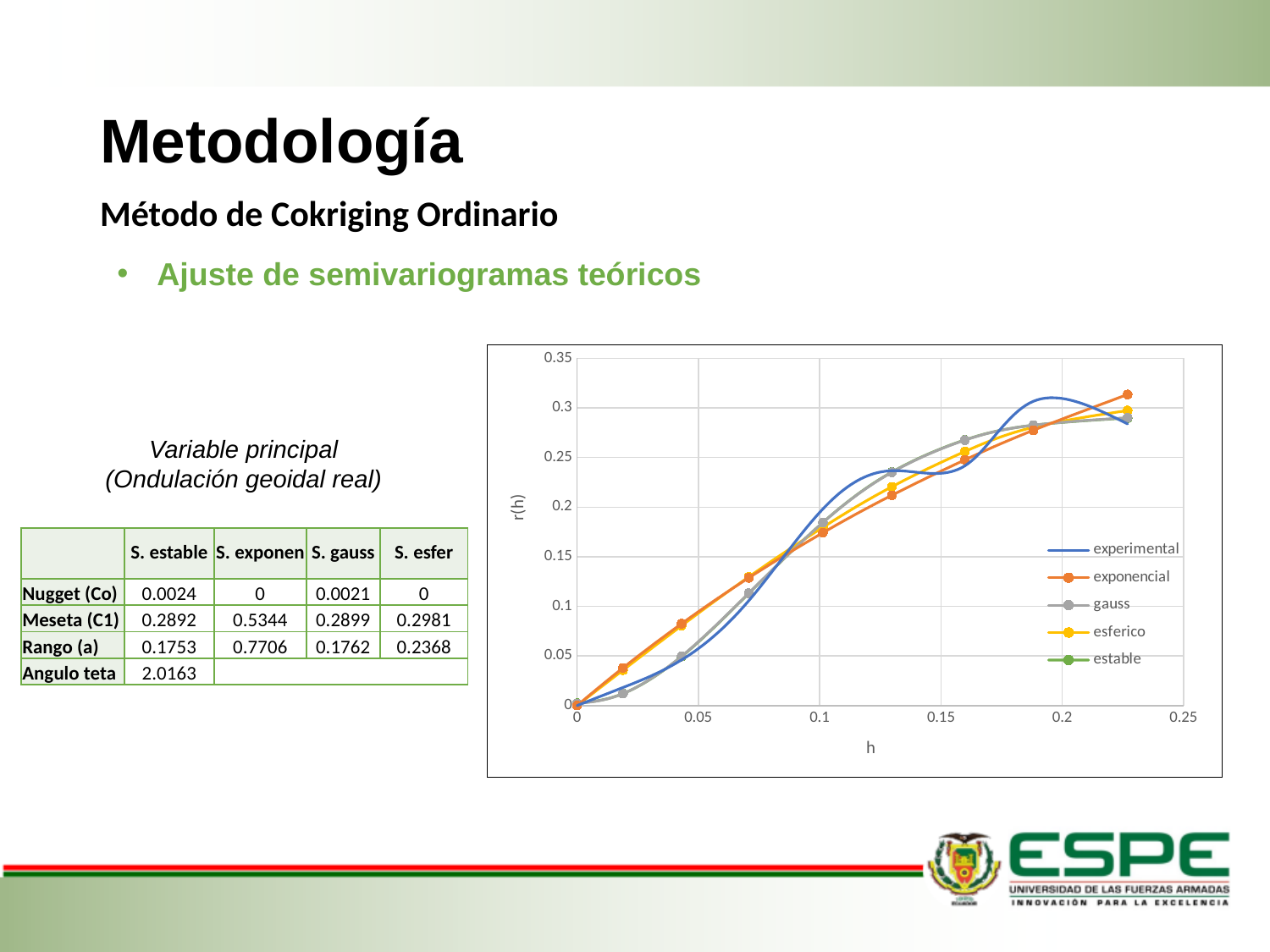
Is the value of the gauss series at h = 0.05 greater or less than 0.1? less What is the highest tick value shown on the vertical axis of the chart? 0.35 Is the value of the exponencial series at h = 0.1 greater or less than 0.15? greater How many series does the chart's legend list? 5 What is the label of the chart's horizontal axis? h Is the value of the exponencial series at h = 0.1 greater or less than 0.2? less What kind of chart is shown on the slide? line chart At the largest h value plotted, which series has the highest r(h)? exponencial Do the values of the exponencial series rise or fall as h increases? rise What are the series names listed in the chart's legend? experimental, exponencial, gauss, esferico, estable